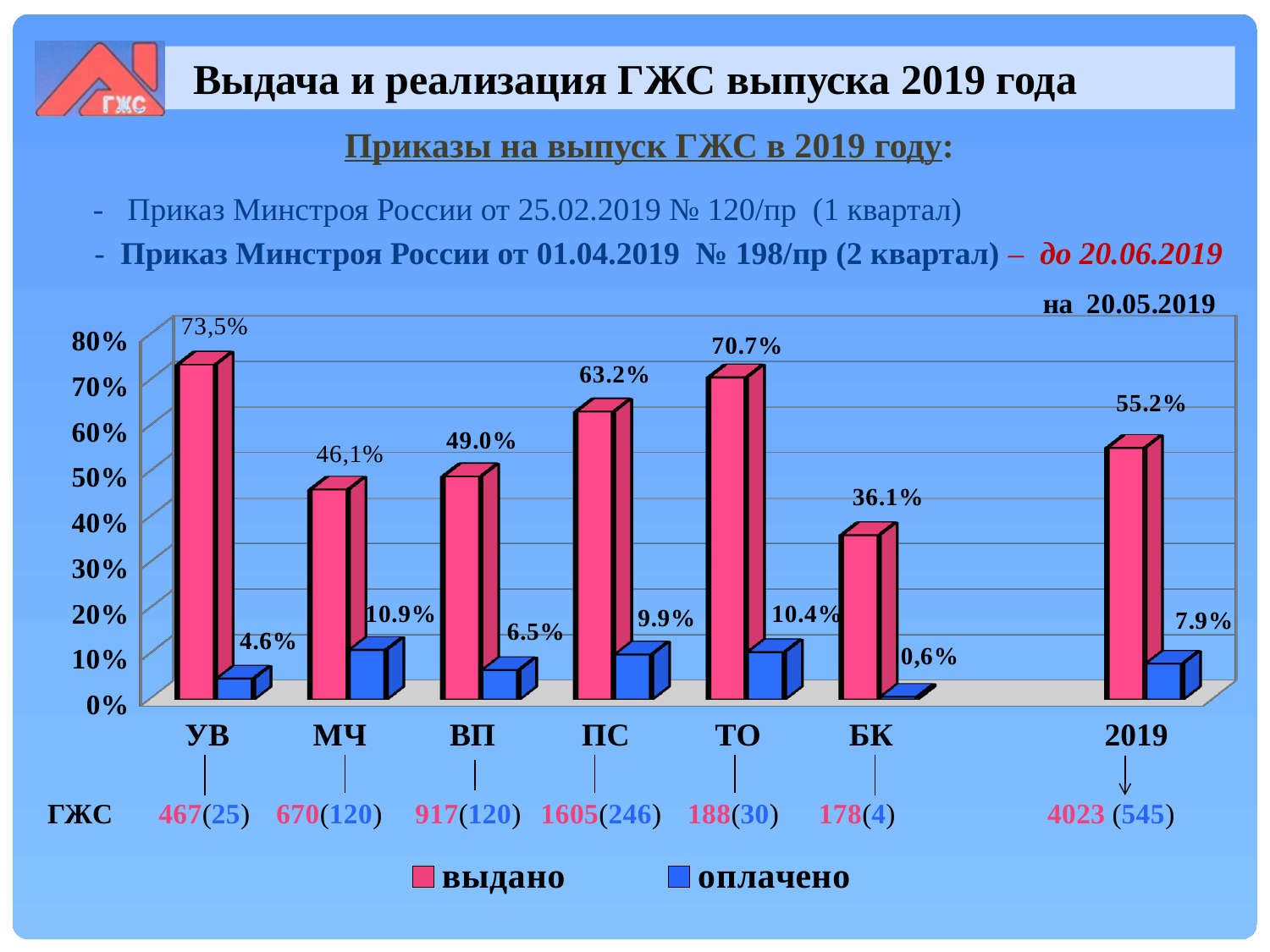
How many series does the legend list? 2 What kind of chart is shown on the slide? bar chart Which is larger, the оплачено value for МЧ or for ВП? МЧ Which category has the lowest оплачено value? БК What is the value of the выдано bar for ПС? 63.2% Which category has the lowest выдано value? БК What is the value of the оплачено bar for ТО? 10.4% How many categories are shown on the x axis of the chart? 7 Which category has the highest выдано value? УВ What is the difference between the выдано values for ТО and ПС? 7.5% Is the выдано value for МЧ greater or less than 50%? less What is the value of the выдано bar for 2019? 55.2%